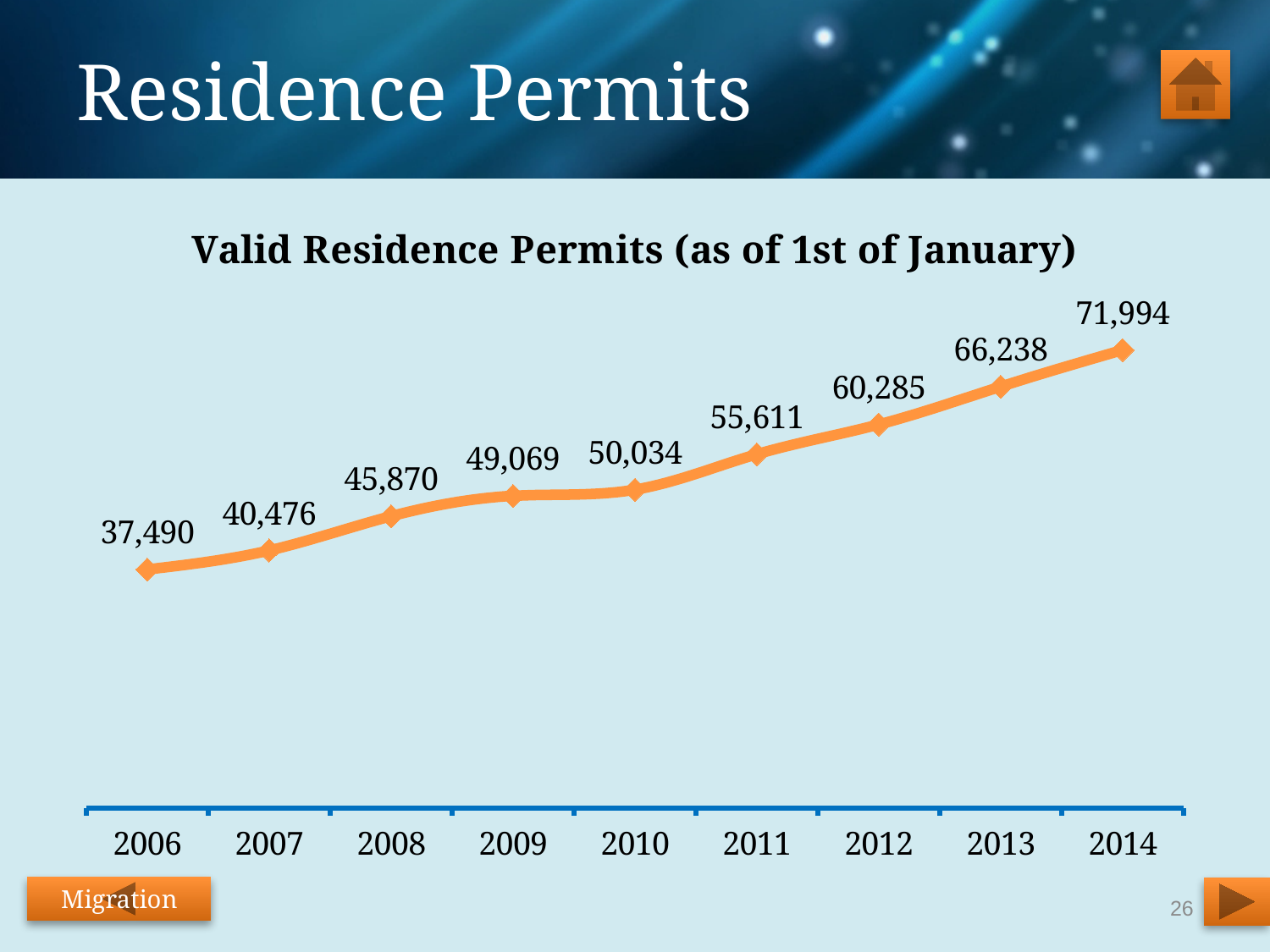
What is the difference between the values for 2014 and 2013? 5,756 What is the value of valid residence permits for 2014? 71,994 How many years are plotted on the chart? 9 What is the title of the chart? Valid Residence Permits (as of 1st of January) Which is larger, the value for 2011 or the value for 2012? 2012 Which year has the lowest number of valid residence permits? 2006 What is the value of valid residence permits for 2010? 50,034 What is the value of valid residence permits for 2006? 37,490 What kind of chart is shown on the slide? Line chart What is the difference between the values for 2010 and 2009? 965 Which year has the highest number of valid residence permits? 2014 Do the values rise or fall from 2006 to 2014? Rise